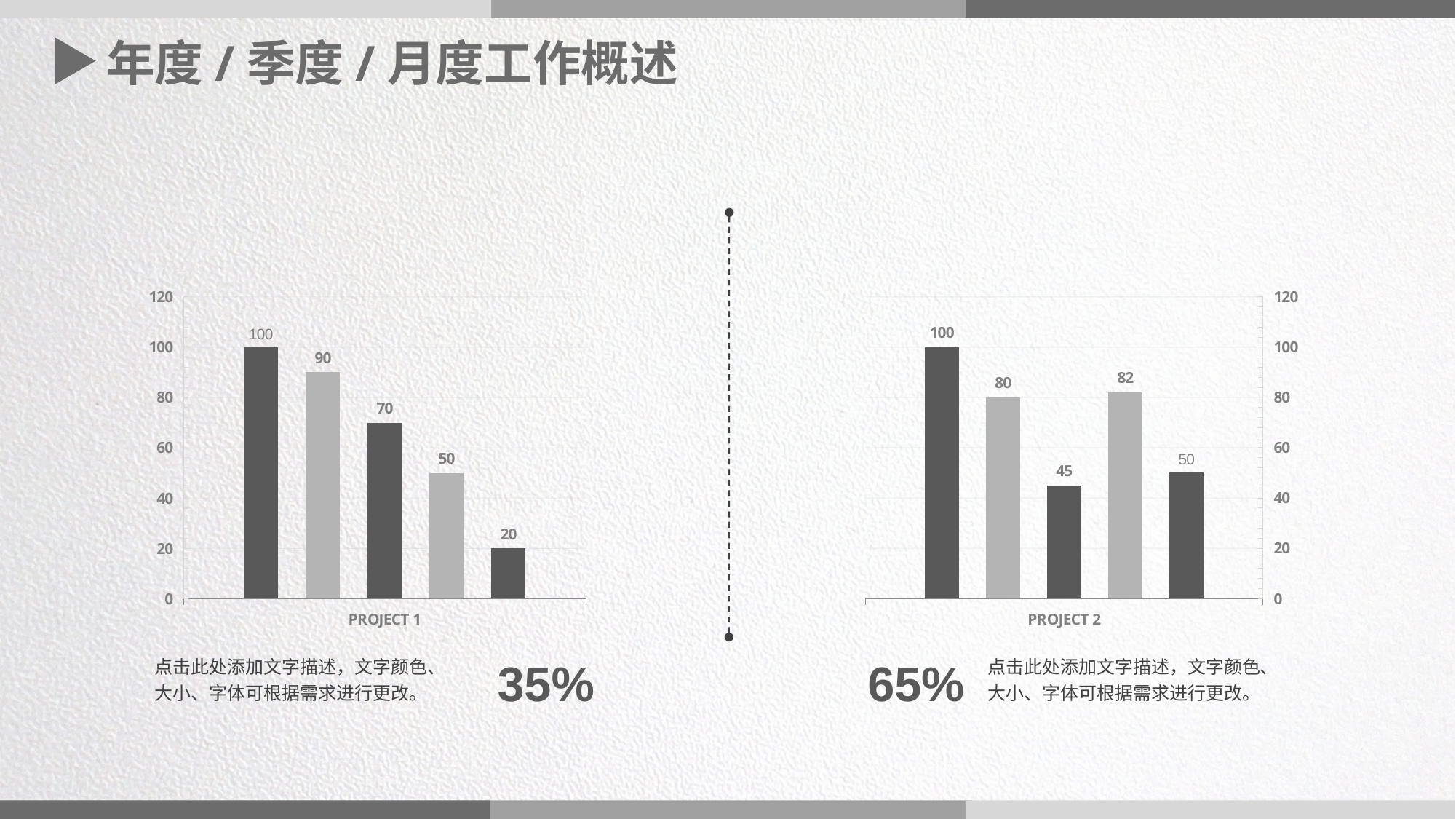
In the PROJECT 2 chart on the right, what is the lowest value shown? 45 In the PROJECT 1 chart on the left, what is the value of the last (rightmost) bar? 20 What type of chart is the PROJECT 2 chart on the right? bar chart In the PROJECT 1 chart on the left, what is the highest value shown? 100 In the PROJECT 1 chart on the left, do the bar values rise or fall from left to right? fall In the PROJECT 2 chart on the right, what is the value of the third bar? 45 In the PROJECT 1 chart on the left, what is the value of the first (leftmost) bar? 100 In the PROJECT 1 chart on the left, what is the difference between the first bar (100) and the last bar (20)? 80 In the PROJECT 2 chart on the right, which is larger: the second bar or the fourth bar? the fourth bar (82) In the PROJECT 2 chart on the right, what is the value of the fourth bar? 82 In the PROJECT 2 chart on the right, what is the difference between the second bar (80) and the third bar (45)? 35 How many bars are plotted in the PROJECT 1 chart on the left? 5